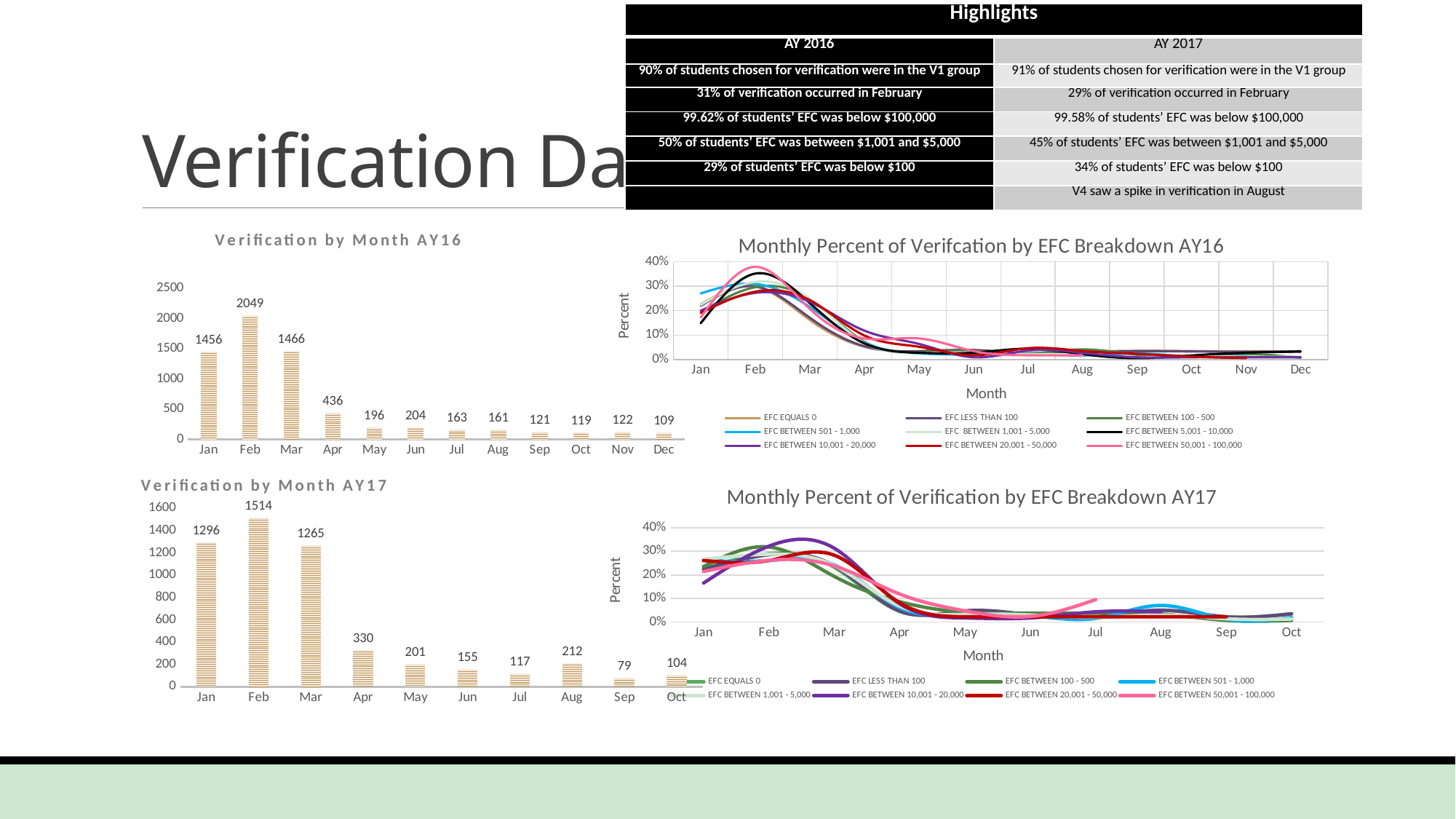
In the Verification by Month AY17 chart, which is larger, the value for Jul or the value for Aug? Aug In the Verification by Month AY17 chart, which month has the highest value? Feb In the Verification by Month AY17 chart, what is the difference between the Feb and Mar values? 249 In the Verification by Month AY16 chart, what is the value for Feb? 2049 In the Verification by Month AY17 chart, which month has the lowest value? Sep In the Verification by Month AY16 chart, which month has the highest value? Feb In the Verification by Month AY16 chart, which month has the lowest value? Dec In the Verification by Month AY16 chart, what is the difference between the Feb and Jan values? 593 In the Verification by Month AY17 chart, what is the value for Aug? 212 In the Verification by Month AY17 chart, how many months are shown on the x axis? 10 What kind of chart is the Verification by Month AY16 chart? bar chart In the Monthly Percent of Verifcation by EFC Breakdown AY16 chart, how many series does the legend list? 9